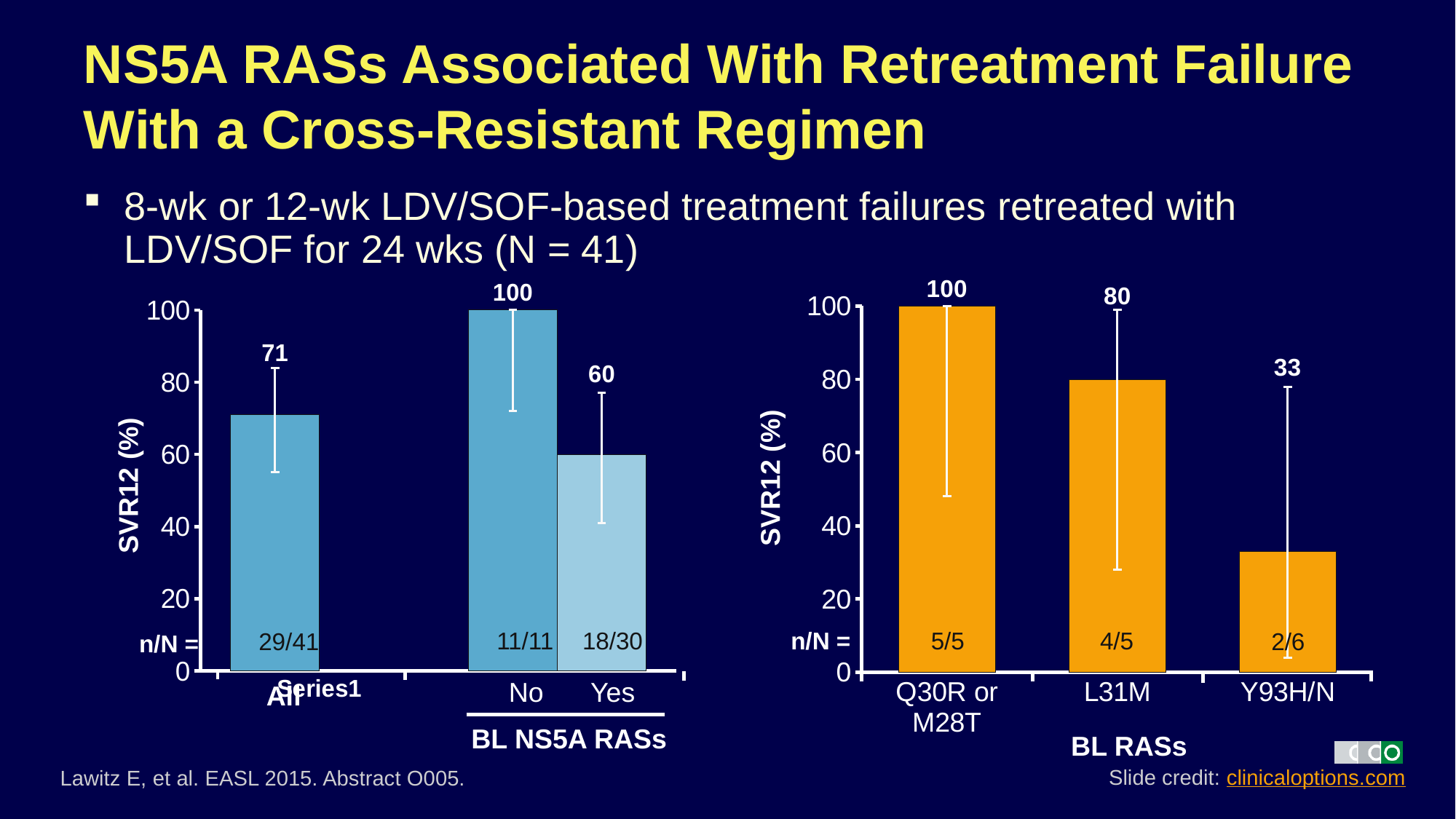
What type of chart is the right chart? bar chart In the right chart, what is the n/N shown for Y93H/N? 2/6 In the right chart, is the SVR12 (%) for Q30R or M28T larger or smaller than that for L31M? larger In the left chart, what is the n/N shown for the All group? 29/41 In the right chart, how many BL RAS categories are plotted? 3 In the right chart, which BL RAS category has the lowest SVR12 (%)? Y93H/N In the right chart, what is the SVR12 (%) for L31M? 80 In the right chart, what is the SVR12 (%) for Y93H/N? 33 In the left chart, what is the SVR12 (%) for patients with baseline NS5A RASs (Yes)? 60 In the left chart, what is the difference in SVR12 (%) between the No and Yes BL NS5A RASs groups? 40 In the left chart, what is the SVR12 (%) for patients with no baseline NS5A RASs? 100 In the left chart, what is the SVR12 (%) for the All group? 71